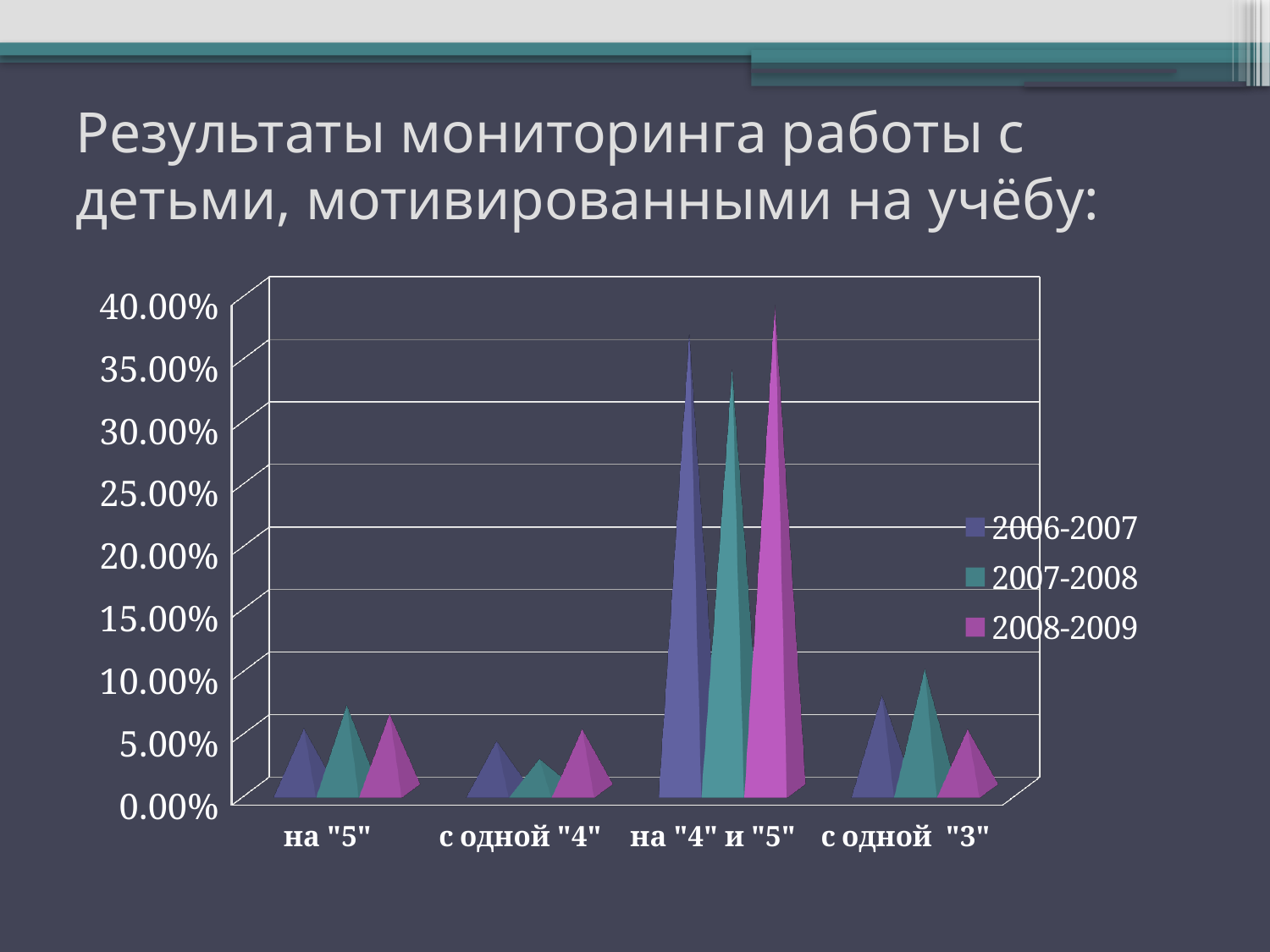
Which category has the lowest value for the 2007-2008 series? с одной "4" Which category has the highest value for the 2008-2009 series? на "4" и "5" How many series does the chart's legend list? 3 Is the value for 2006-2007 in the category на "4" и "5" greater or less than 30.00%? greater In the category с одной "3", which is larger: the value for 2007-2008 or the value for 2008-2009? 2007-2008 Is the value for 2007-2008 in the category на "5" greater or less than 5.00%? greater Which series are listed in the chart's legend? 2006-2007, 2007-2008, 2008-2009 How many categories are shown on the x axis of the chart? 4 Is the value for 2008-2009 in the category на "4" и "5" greater or less than 35.00%? greater Within the category на "4" и "5", which series has the highest value? 2008-2009 What kind of chart is shown on the slide? bar chart